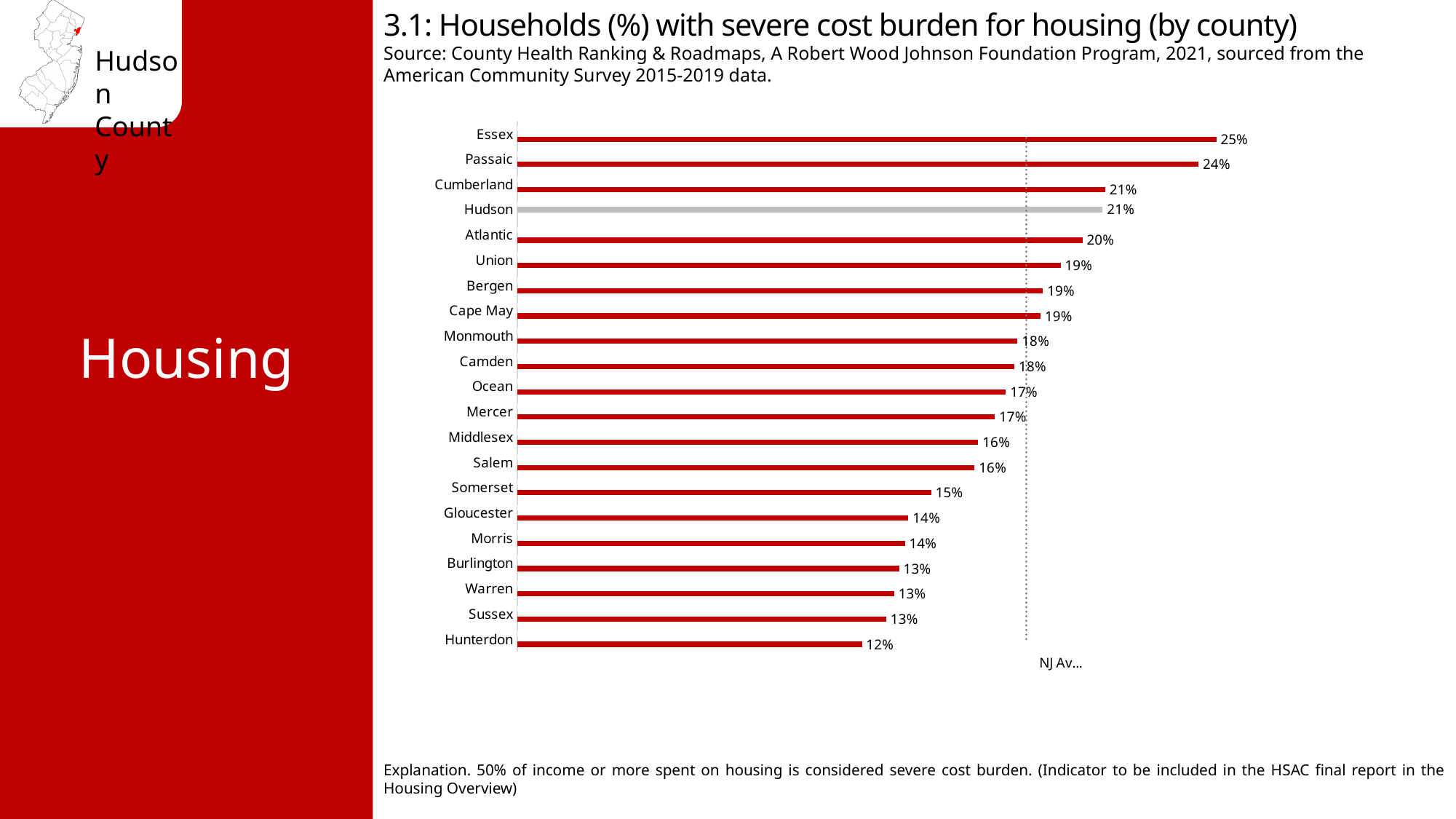
How many counties are shown in the chart? 21 Which county has the highest value? Essex Which is larger, the value for Union or the value for Middlesex? Union What is the difference between the values for Essex and Hunterdon? 13% What kind of chart is this? Bar chart What is the value for Atlantic? 20% What is the value for Hunterdon? 12% What is the difference between the values for Passaic and Somerset? 9% Which county's bar is shown in grey instead of red? Hudson Which county has the lowest value? Hunterdon What is the value for Essex? 25% What is the value for Hudson? 21%